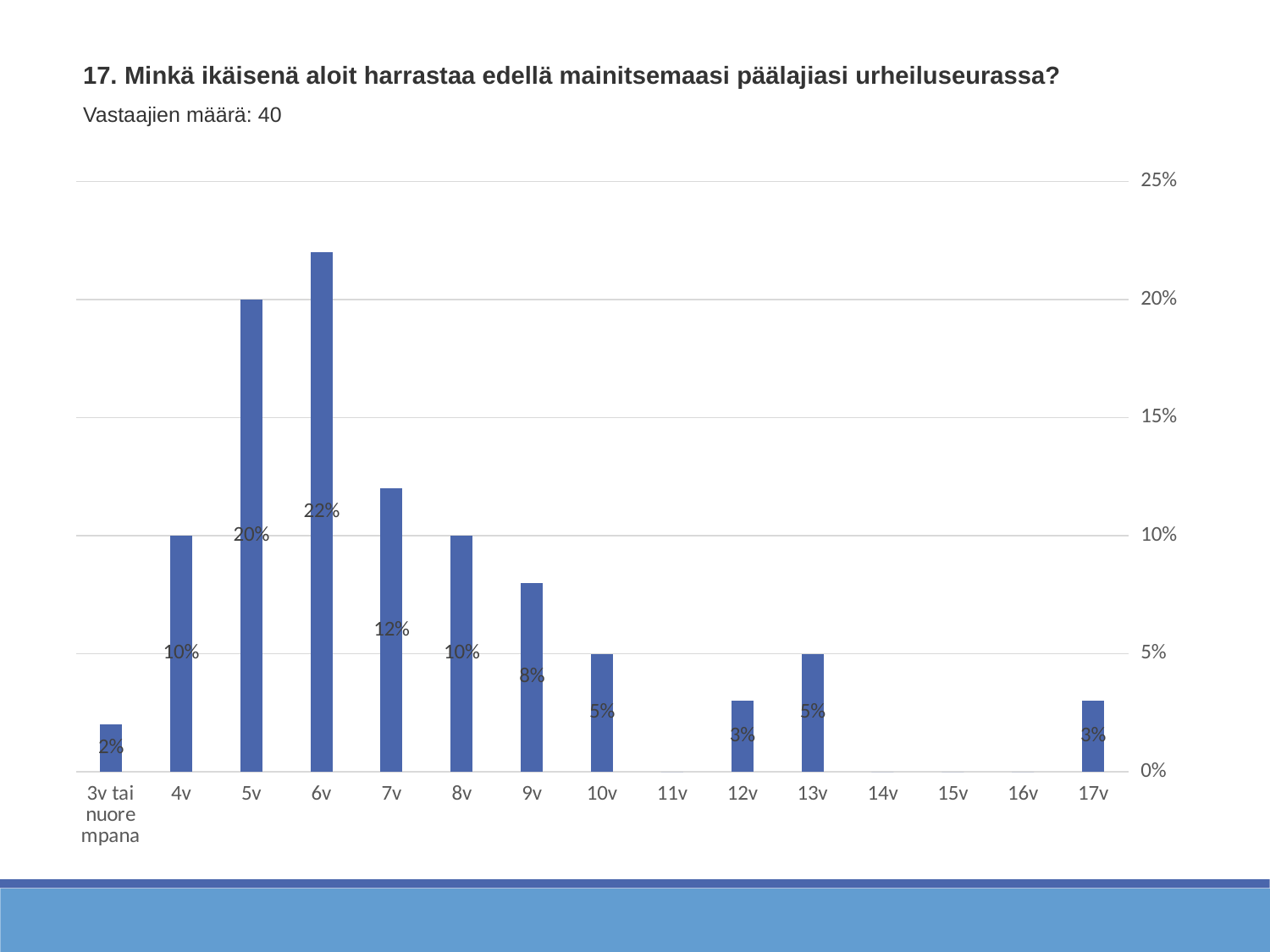
What is the difference between the values for 6v and 7v? 10% How many respondents (Vastaajien määrä) are reported on the slide? 40 What percentage is shown for 9v? 8% What kind of chart is shown on the slide? bar chart Do the values rise or fall from 6v to 10v along the x axis? fall What is the value shown for the 5v category? 20% How many age categories are shown on the x axis? 15 What is the value for the '3v tai nuorempana' category? 2% Which is larger, the value for 4v or the value for 9v? 4v Which age category has the highest percentage? 6v What percentage of respondents started at age 6v? 22% Is the value for 5v greater or less than 15%? greater